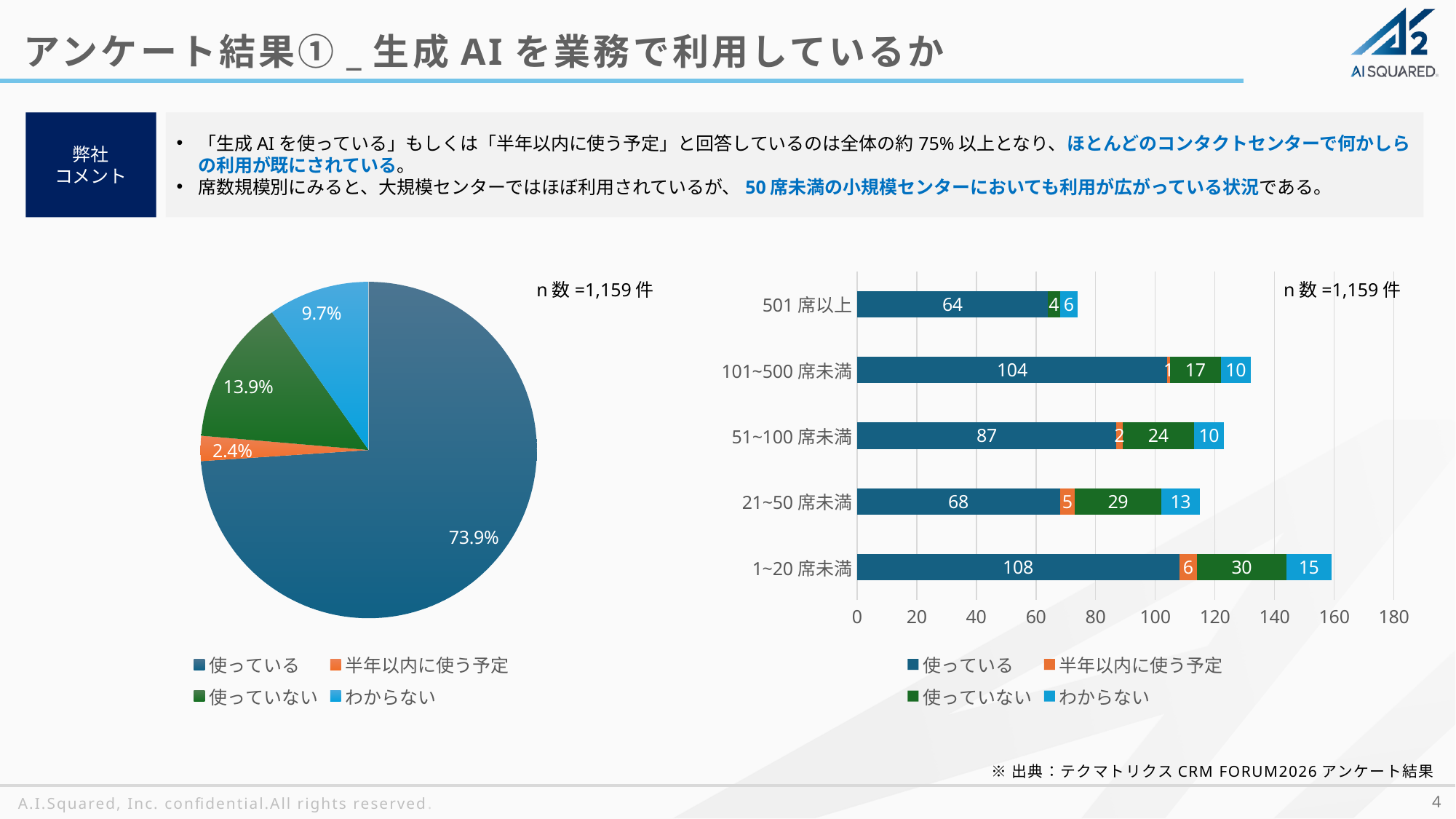
In the bar chart on the right, what is the value of 使っていない for 21~50席未満? 29 How many categories are shown in the bar chart on the right? 5 In the bar chart on the right, what is the total of the stacked bar for 1~20席未満? 159 How many series does the legend of the bar chart on the right list? 4 In the pie chart on the left, what share is labelled for 使っている? 73.9% In the bar chart on the right, which has the larger わからない value, 21~50席未満 or 51~100席未満? 21~50席未満 What kind of chart is the chart on the left of the slide? pie chart In the pie chart on the left, which category has the smallest slice? 半年以内に使う予定 In the bar chart on the right, what is the value of 使っている for 1~20席未満? 108 In the bar chart on the right, which category has the highest value for 使っている? 1~20席未満 In the pie chart on the left, what share is labelled for わからない? 9.7% In the bar chart on the right, what is the difference between the 使っている values for 1~20席未満 and 101~500席未満? 4